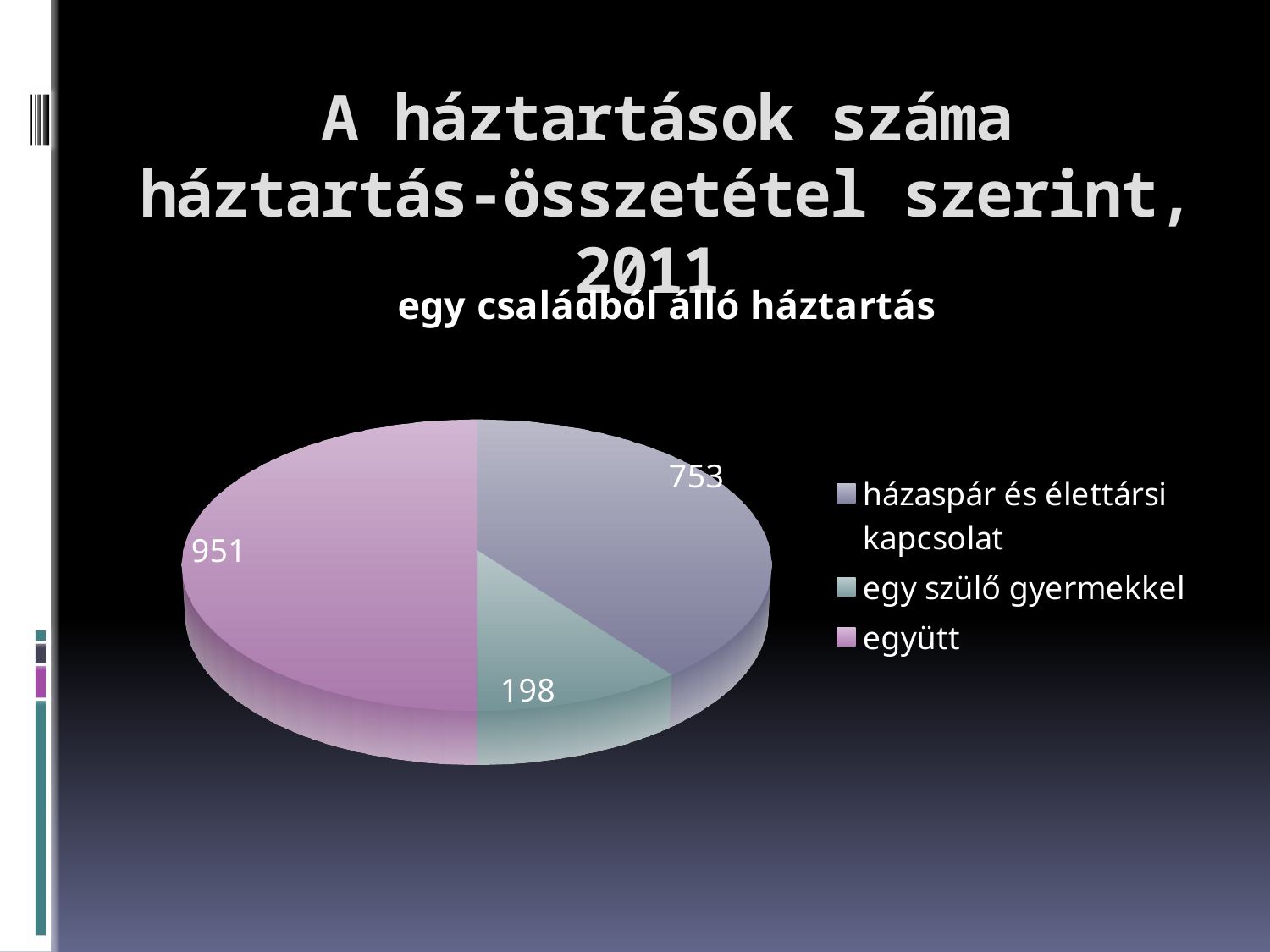
Which is larger, the value for "házaspár és élettársi kapcsolat" or the value for "egy szülő gyermekkel"? házaspár és élettársi kapcsolat What is the value for "együtt" in the pie chart? 951 What is the difference between the values for "együtt" and "házaspár és élettársi kapcsolat"? 198 What is the difference between the values for "házaspár és élettársi kapcsolat" and "egy szülő gyermekkel"? 555 Which category has the largest slice in the pie chart? együtt What is the title of the chart on the slide? egy családból álló háztartás How many slices does the pie chart have? 3 What kind of chart is shown on the slide? pie chart What share of the pie does the "együtt" slice represent? 50% What is the value for "egy szülő gyermekkel" in the pie chart? 198 What is the value for "házaspár és élettársi kapcsolat" in the pie chart? 753 Which category has the smallest slice in the pie chart? egy szülő gyermekkel